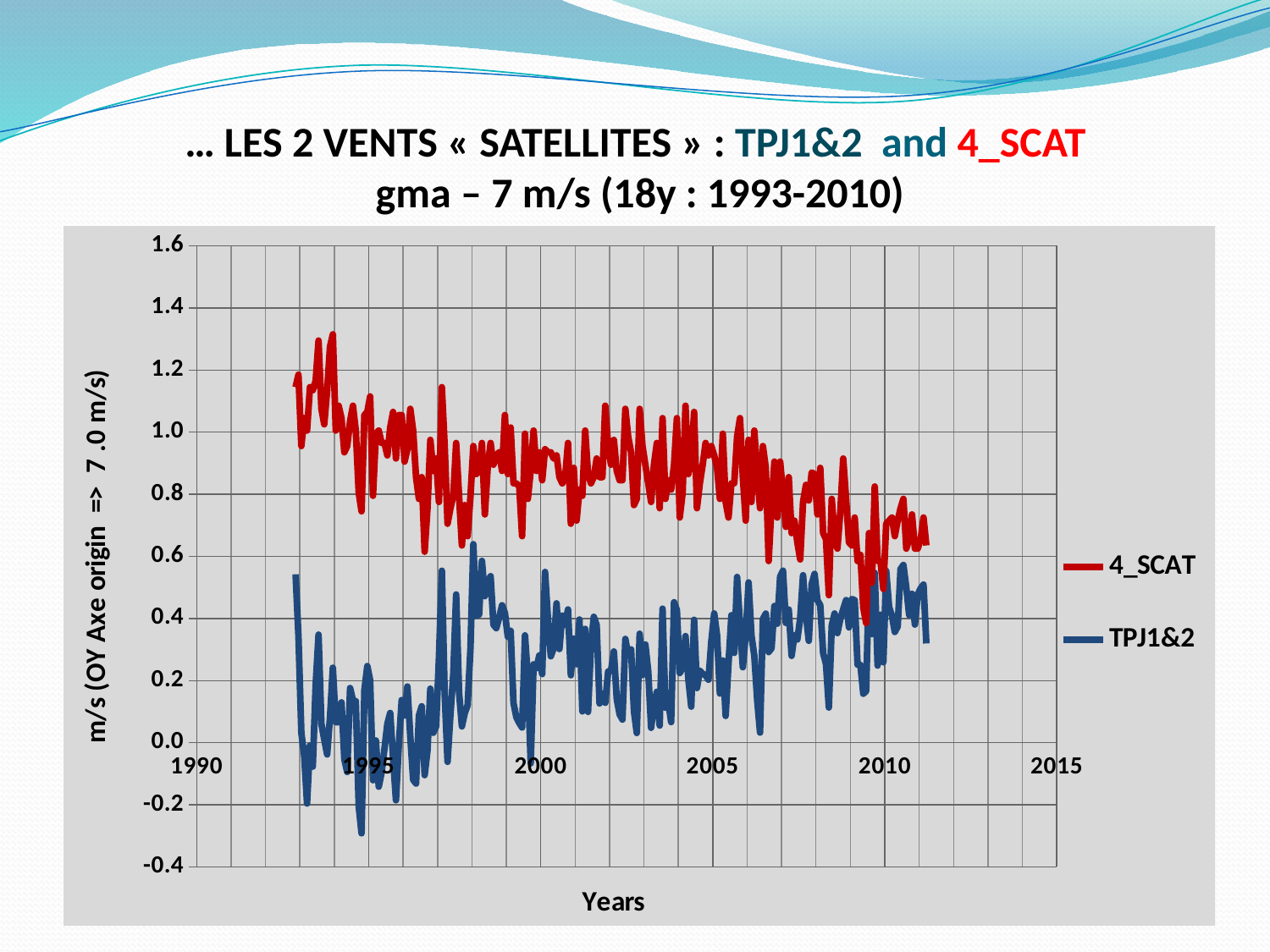
What colour is the 4_SCAT line? red Around the year 2000, which series has the higher values, 4_SCAT or TPJ1&2? 4_SCAT Does the TPJ1&2 series generally rise or fall from the mid-1990s to 2010? rise Is the highest value reached by 4_SCAT greater or less than 1.2? greater What are the two series named in the legend? 4_SCAT and TPJ1&2 Is the value of TPJ1&2 around 2005 greater or less than 0.8? less Does the 4_SCAT series generally rise or fall from 1993 to 2010? fall Is the value of 4_SCAT around 1995 greater or less than 0.6? greater What kind of chart is shown on the slide? line chart How many series does the legend list? 2 How many year labels are printed on the x axis? 6